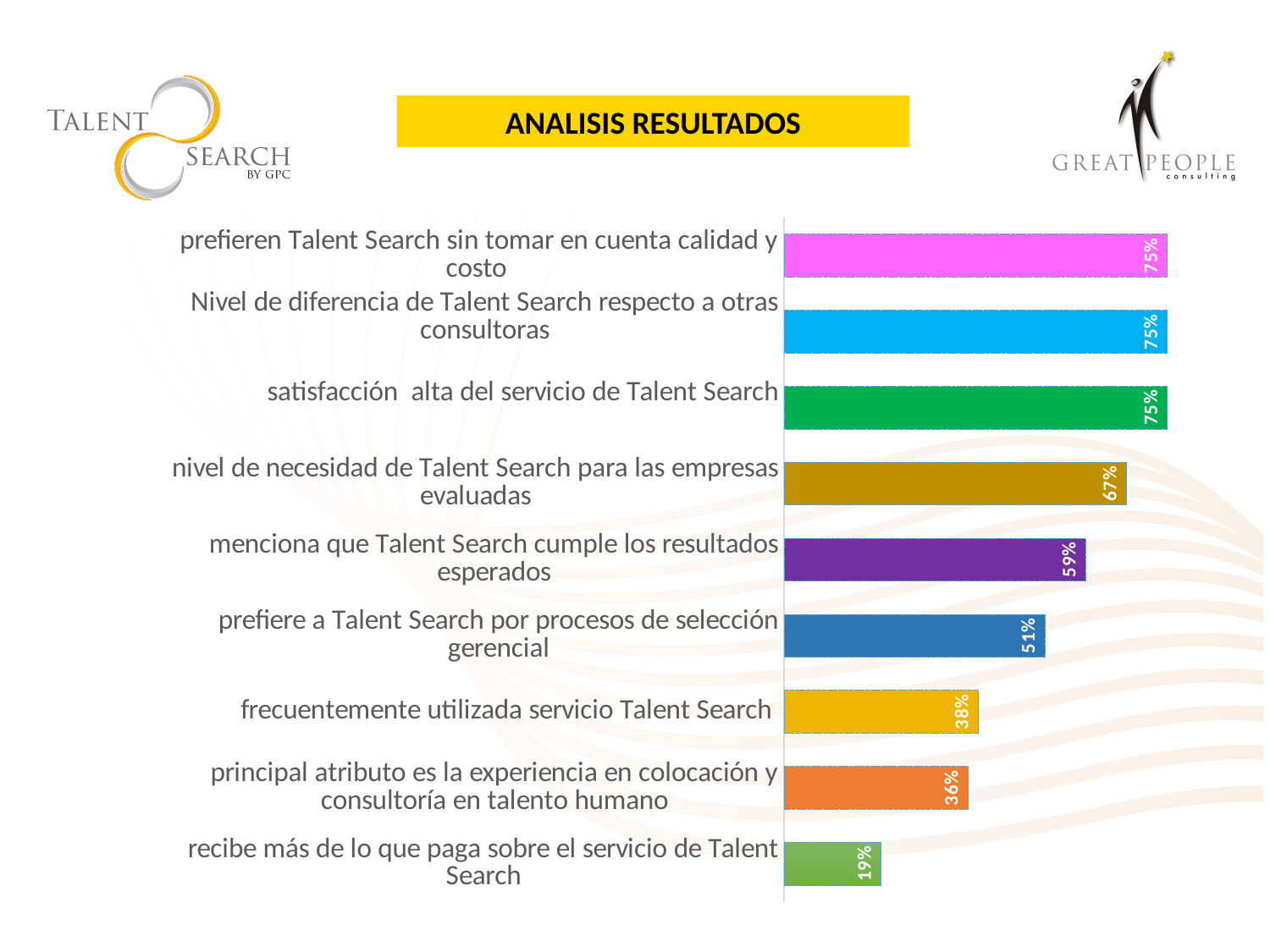
What is the highest value shown on the chart? 75% What value is shown for "prefiere a Talent Search por procesos de selección gerencial"? 51% What value is shown for "recibe más de lo que paga sobre el servicio de Talent Search"? 19% Which category has the lowest value? recibe más de lo que paga sobre el servicio de Talent Search What value is shown for "frecuentemente utilizada servicio Talent Search"? 38% What value is shown for "nivel de necesidad de Talent Search para las empresas evaluadas"? 67% What is the difference between "nivel de necesidad de Talent Search para las empresas evaluadas" and "recibe más de lo que paga sobre el servicio de Talent Search"? 48% What is the difference between "menciona que Talent Search cumple los resultados esperados" and "frecuentemente utilizada servicio Talent Search"? 21% What kind of chart is shown on the slide? bar chart Which is larger: "principal atributo es la experiencia en colocación y consultoría en talento humano" or "prefiere a Talent Search por procesos de selección gerencial"? prefiere a Talent Search por procesos de selección gerencial How many categories share the top value of 75%? 3 How many categories are shown on the chart? 9